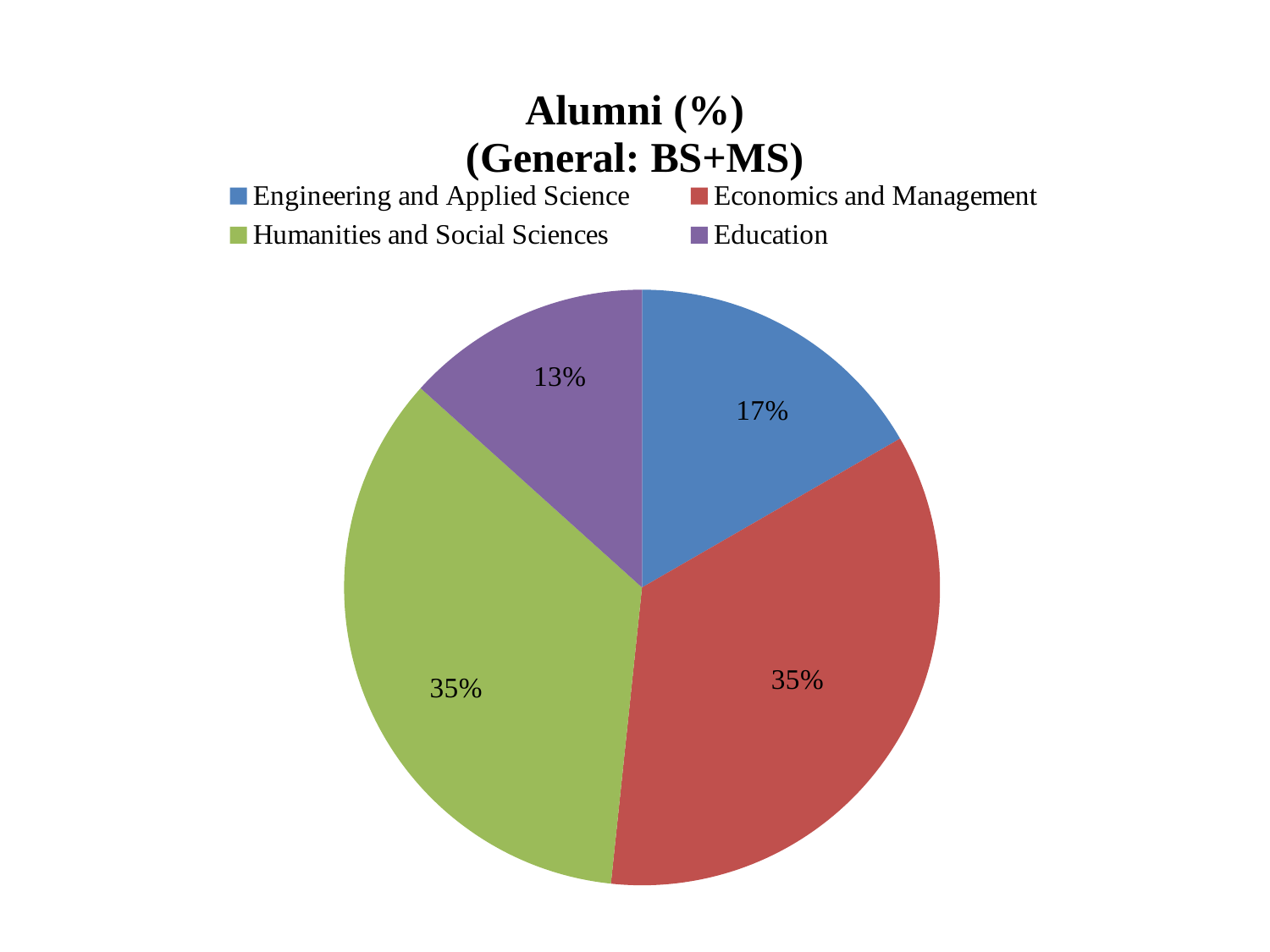
Which category has the smallest share of alumni? Education What share of alumni is Economics and Management? 35% How many categories does the pie chart show? 4 What kind of chart is shown on the slide? Pie chart Which colour represents Humanities and Social Sciences in the legend? Green What is the difference in percentage points between Engineering and Applied Science and Education? 4 What is the title of the chart? Alumni (%) (General: BS+MS) What share of alumni is Engineering and Applied Science? 17% What share of alumni is Humanities and Social Sciences? 35% What is the difference in percentage points between Economics and Management and Engineering and Applied Science? 18 Which is larger, the share for Engineering and Applied Science or the share for Education? Engineering and Applied Science